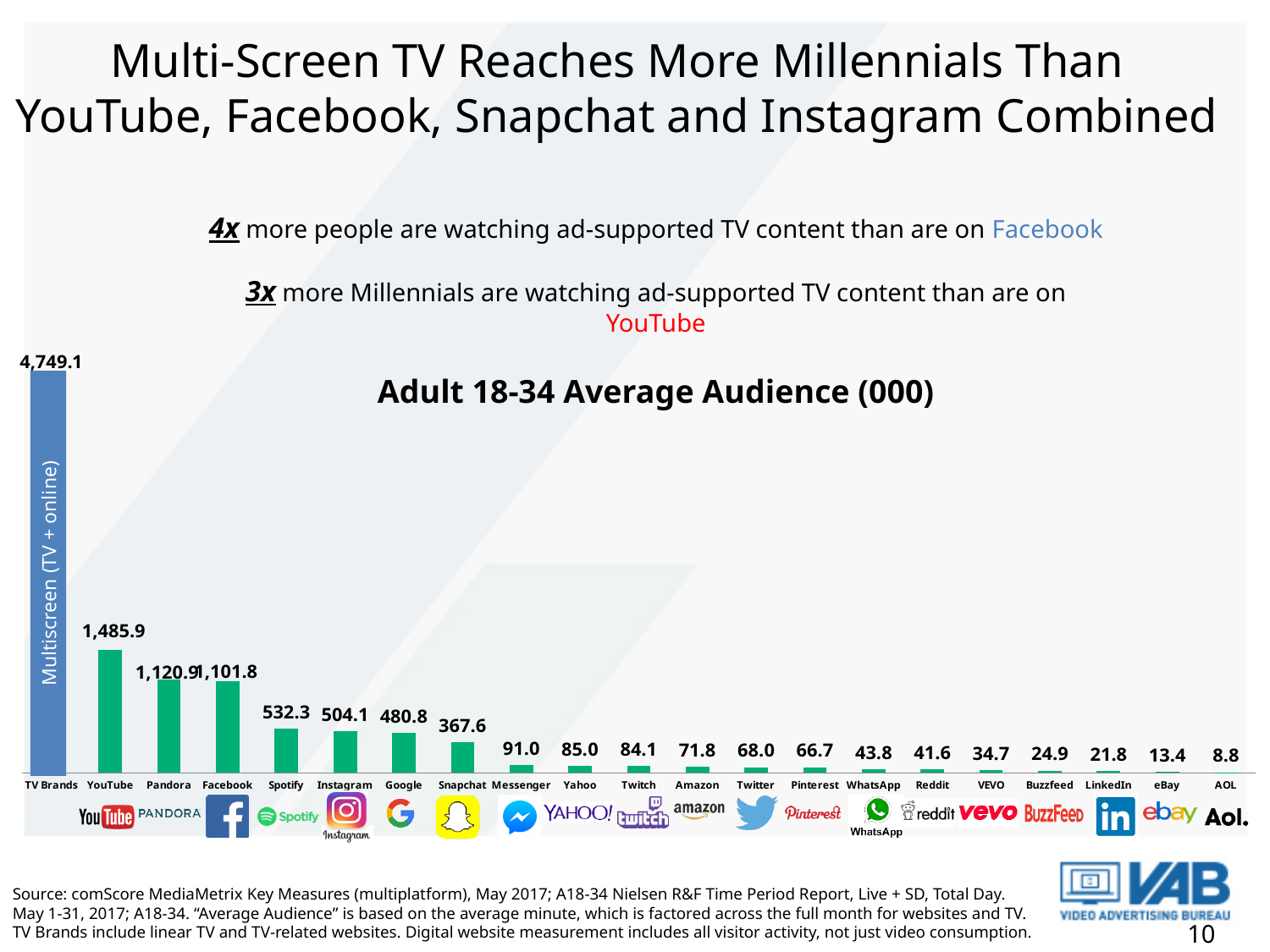
Which category has the highest Adult 18-34 average audience? TV Brands What is the Adult 18-34 average audience (000) for Snapchat? 367.6 Which has a larger Adult 18-34 average audience, Twitter or Amazon? Amazon How many categories are shown in the chart? 21 What is the Adult 18-34 average audience (000) for TV Brands? 4,749.1 What is the Adult 18-34 average audience (000) for Pinterest? 66.7 What is the difference between the TV Brands value and the YouTube value? 3,263.2 What kind of chart is shown on the slide? Bar chart What is the title of the chart? Adult 18-34 Average Audience (000) Which has a larger Adult 18-34 average audience, Spotify or Instagram? Spotify Which category has the lowest Adult 18-34 average audience? AOL What is the difference between the Facebook value and the Snapchat value? 734.2